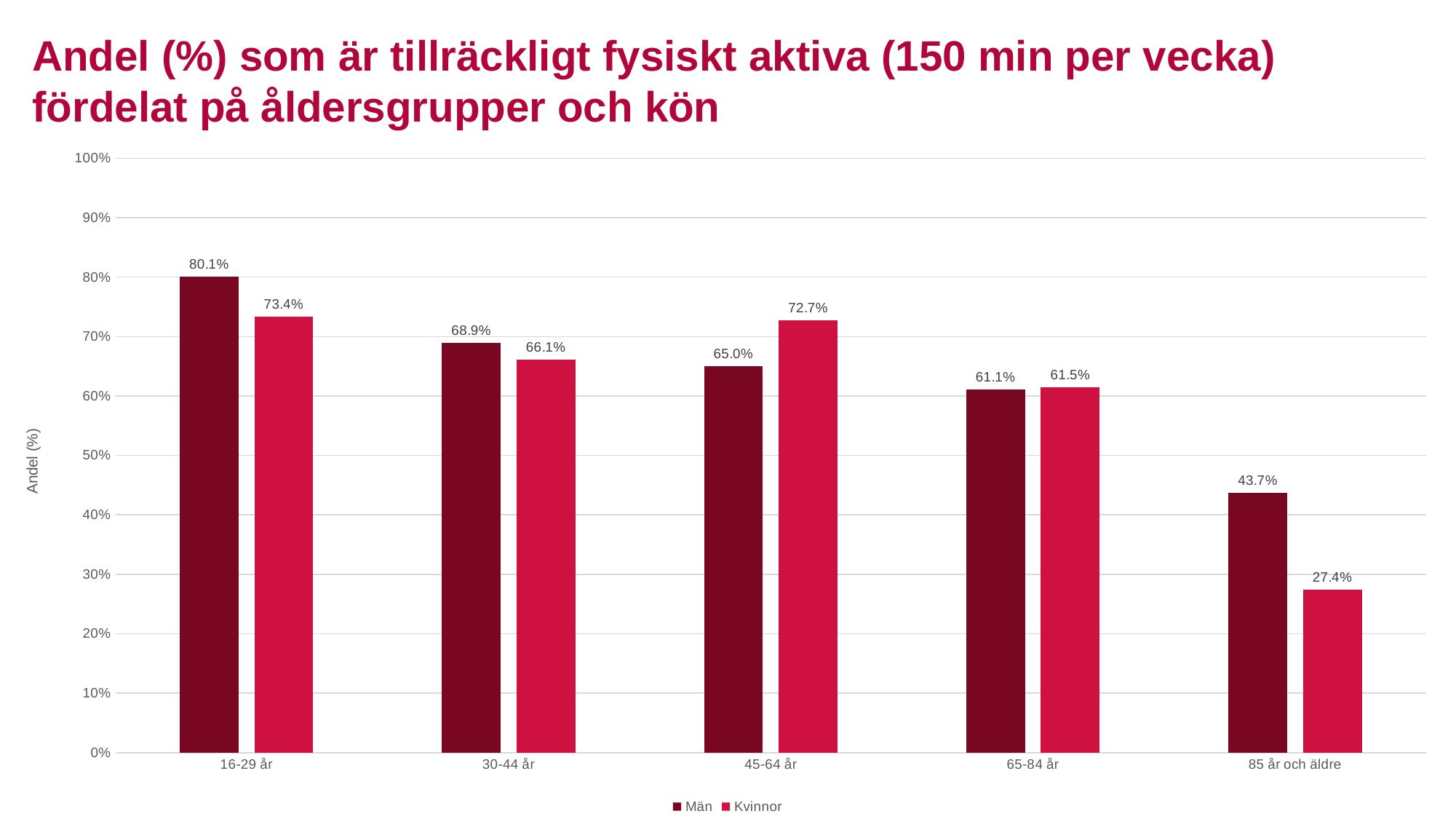
What is the value for Män in the 16-29 år age group? 80.1% What kind of chart is shown on the slide? Bar chart Which age group has the lowest value for Kvinnor? 85 år och äldre Is the value for Män in the 30-44 år age group greater or less than 60%? greater What is the difference between Män and Kvinnor in the 85 år och äldre age group? 16.3% What is the value for Kvinnor in the 45-64 år age group? 72.7% What is the difference between Män and Kvinnor in the 16-29 år age group? 6.7% How many age groups are shown on the x axis? 5 How many series does the legend list? 2 What is the value for Kvinnor in the 85 år och äldre age group? 27.4% In the 45-64 år age group, which is larger: Män or Kvinnor? Kvinnor Which age group has the highest value for Män? 16-29 år